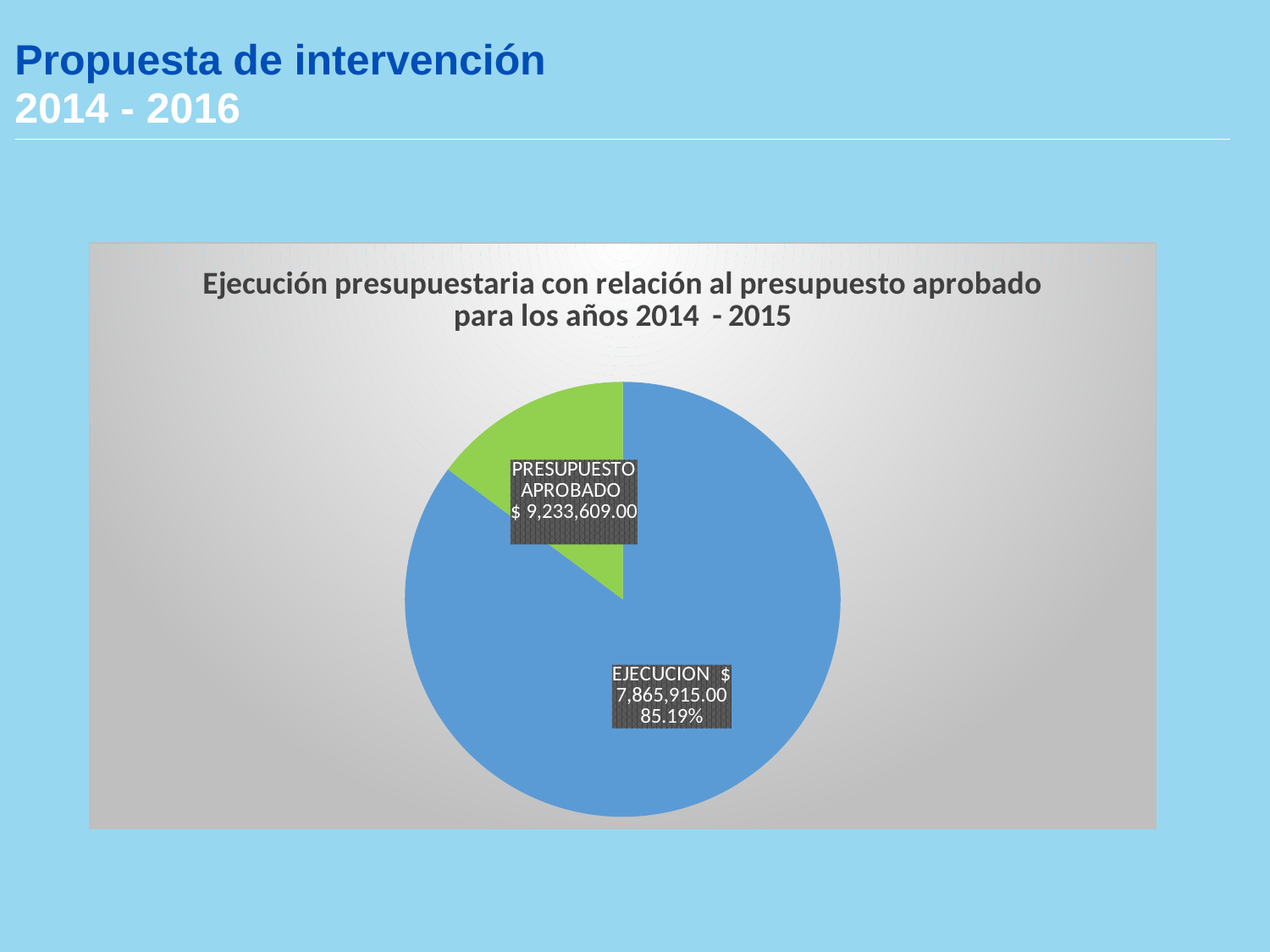
What value is shown for EJECUCION? $ 7,865,915.00 What is the title of the chart? Ejecución presupuestaria con relación al presupuesto aprobado para los años 2014 - 2015 What colour is the EJECUCION slice? blue According to the data labels, which has the larger value: PRESUPUESTO APROBADO or EJECUCION? PRESUPUESTO APROBADO What kind of chart is shown on the slide? pie chart What is the difference between the PRESUPUESTO APROBADO value and the EJECUCION value? $ 1,367,694.00 What percentage is shown on the EJECUCION slice? 85.19% How many slices does the pie chart have? 2 Which years does the chart title say the data covers? 2014 - 2015 What value is shown for PRESUPUESTO APROBADO? $ 9,233,609.00